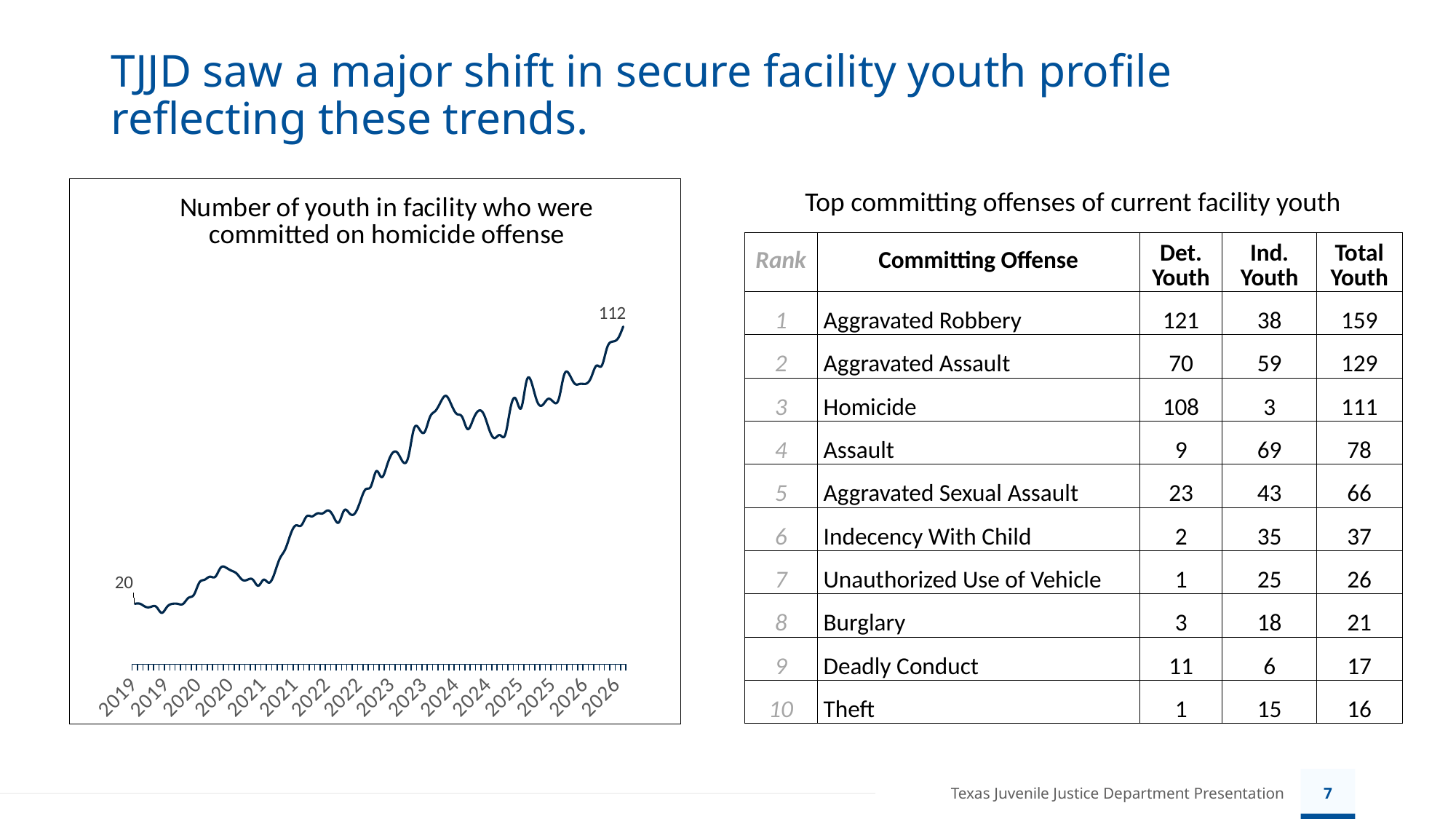
In the chart of youth committed on homicide offense, what value is labeled at the end of the line in 2026? 112 In the chart of youth committed on homicide offense, in which year does the lowest point of the line occur? 2019 What is the earliest year shown on the x axis of the chart on the left? 2019 In the chart of youth committed on homicide offense, do the values generally rise or fall from 2019 to 2026? rise In the chart of youth committed on homicide offense, what is the highest labeled value on the line? 112 In the chart of youth committed on homicide offense, what is the difference between the final labeled value and the first labeled value? 92 In the chart of youth committed on homicide offense, what value is labeled at the start of the line in 2019? 20 What is the title of the chart on the left of the slide? Number of youth in facility who were committed on homicide offense What kind of chart is shown on the left of the slide? line chart In the chart of youth committed on homicide offense, which is larger: the value at the start of the line or the value at the end of the line? the value at the end of the line